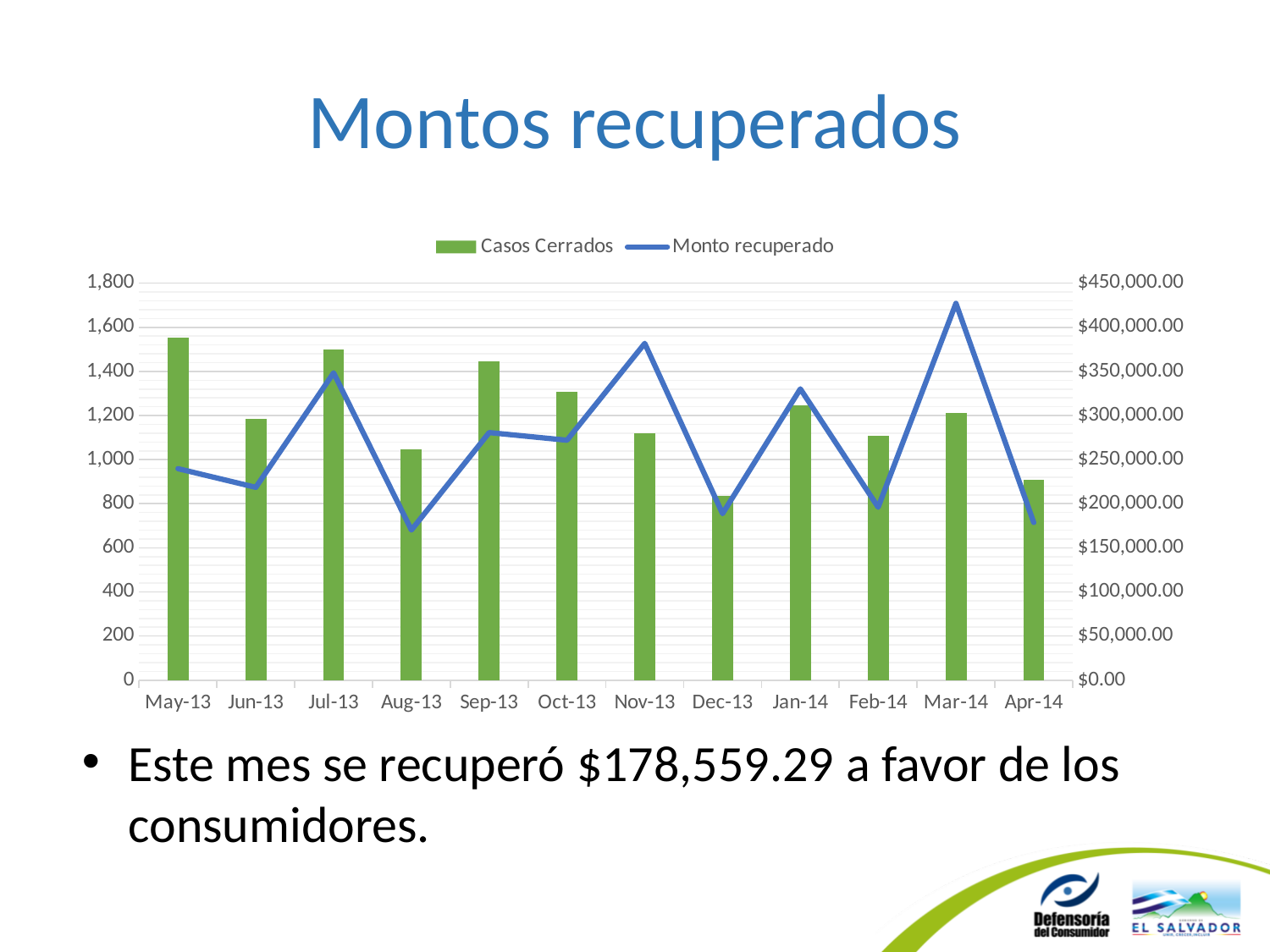
Which month has the highest value for Casos Cerrados? May-13 Which month has more Casos Cerrados, Jul-13 or Aug-13? Jul-13 What kind of chart is shown on the slide? A combination bar and line chart Which month has the highest Monto recuperado? Mar-14 How many months are shown on the x axis? 12 Is the Monto recuperado for Mar-14 greater or less than $400,000.00? greater How many series does the legend list? 2 Is the Monto recuperado for Aug-13 greater or less than $200,000.00? less Which month has the lowest value for Casos Cerrados? Dec-13 Is the Casos Cerrados value for May-13 greater or less than 1,400? greater Does the Monto recuperado rise or fall from Mar-14 to Apr-14? It falls